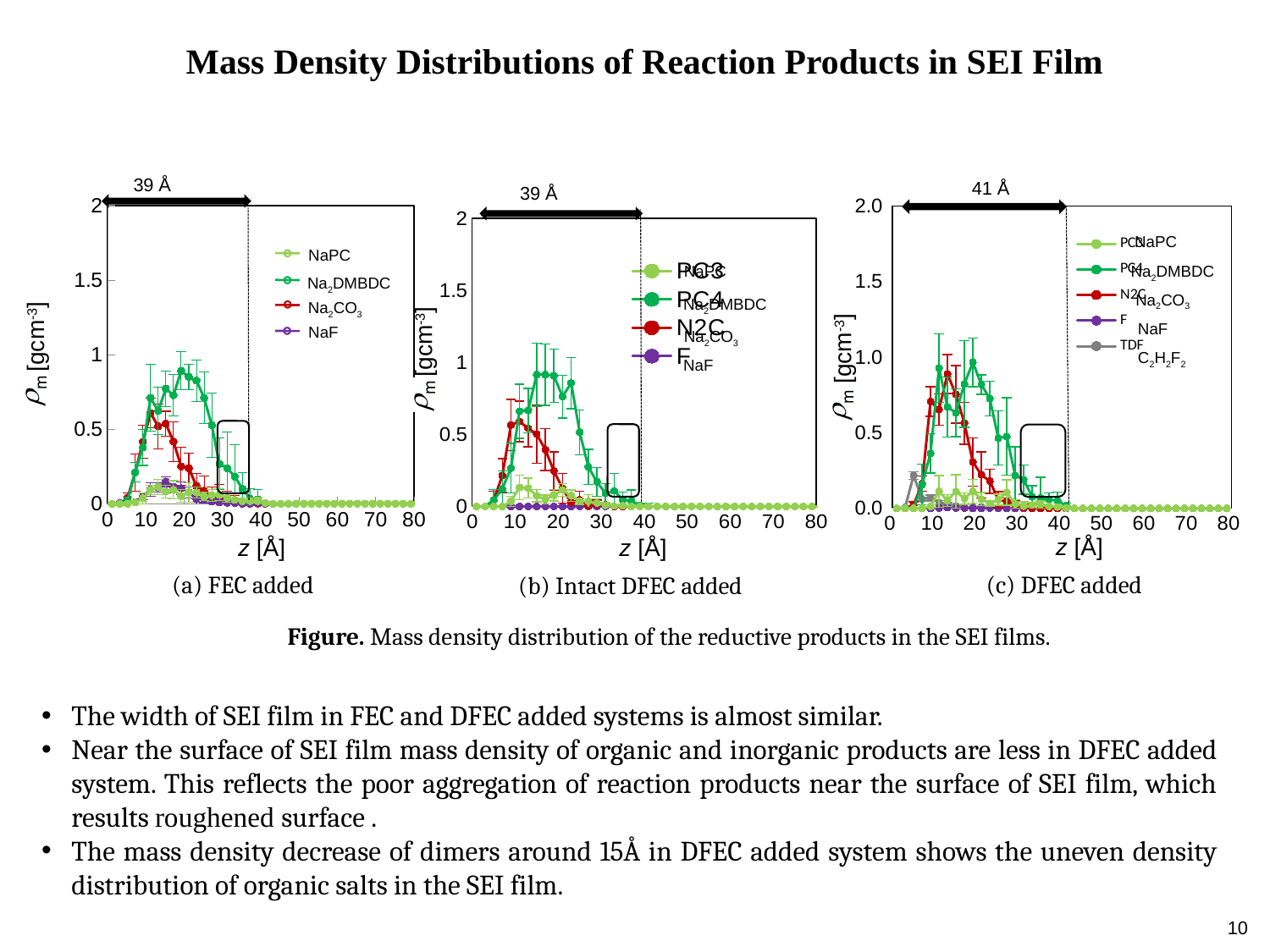
In the (a) FEC added chart, is the peak value of Na2DMBDC greater or less than 0.5? greater In the (c) DFEC added chart, how many series does the legend list? 5 In the (a) FEC added chart, which series reaches a higher peak, Na2DMBDC or NaF? Na2DMBDC In the (c) DFEC added chart, what SEI film width is annotated above the plot? 41 Å In the (b) Intact DFEC added chart, is the peak value of Na2CO3 greater or less than 1.0? less What kind of chart is the (a) FEC added panel? line chart In the (a) FEC added chart, what SEI film width is annotated above the plot? 39 Å In the (c) DFEC added chart, which series reaches a higher peak, Na2DMBDC or NaF? Na2DMBDC In the (b) Intact DFEC added chart, which series reaches the highest mass density? Na2DMBDC In the (a) FEC added chart, does the Na2DMBDC curve rise or fall between z = 20 Å and z = 40 Å? fall In the (a) FEC added chart, is the value of NaF at z = 20 Å greater or less than 0.5? less In the (a) FEC added chart, how many series does the legend list? 4